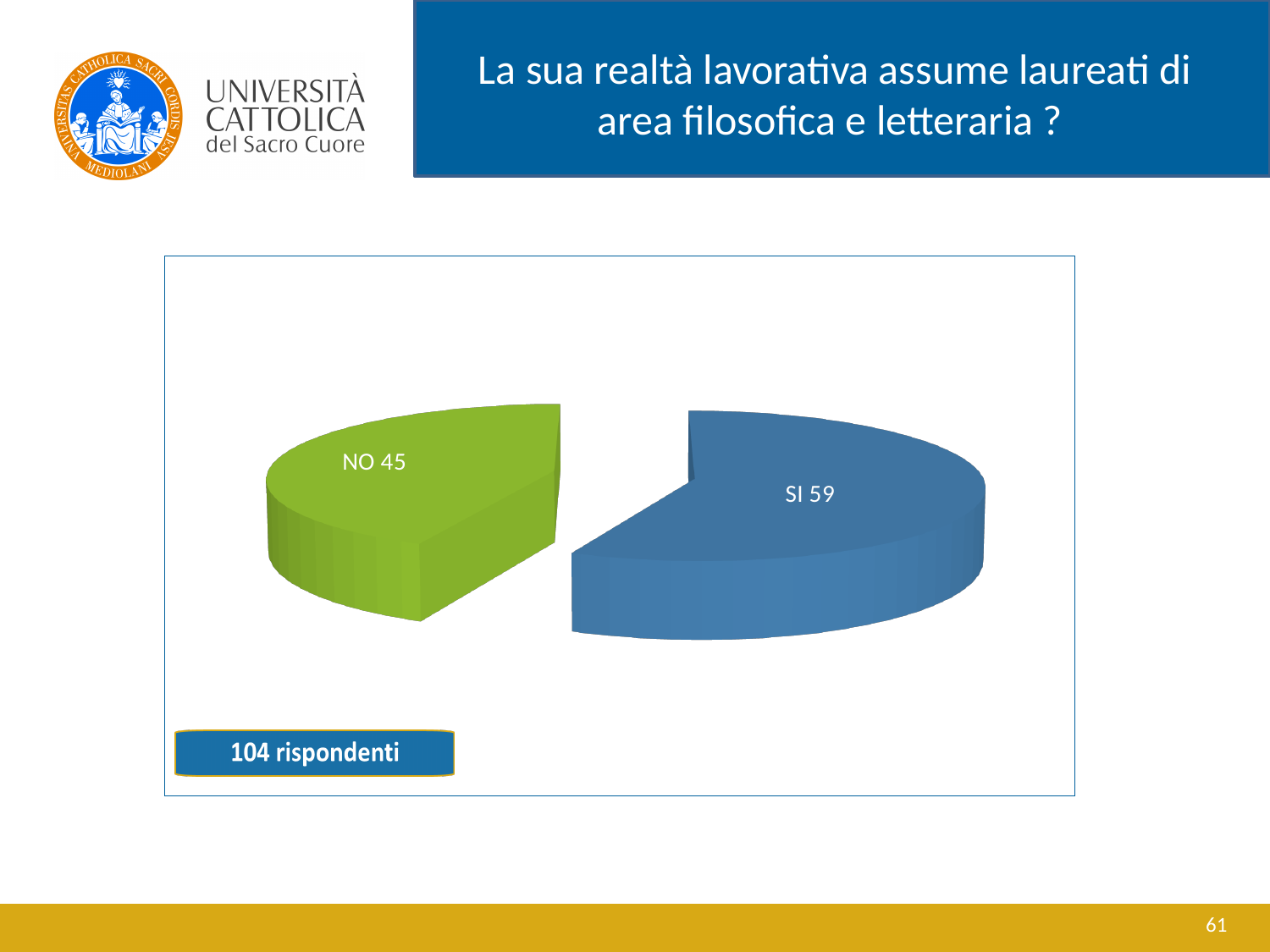
What kind of chart is shown on the slide? pie chart How many slices does the pie chart have? 2 What is the value for the SI slice? 59 What colour is the NO slice? green Which slice is the smallest? NO What is the total of the SI and NO values? 104 How many respondents does the slide report? 104 rispondenti What is the difference between the SI and NO values? 14 What share of the pie does the SI slice represent? 56.7% Which slice is the largest? SI What is the value for the NO slice? 45 Which is larger, SI or NO? SI